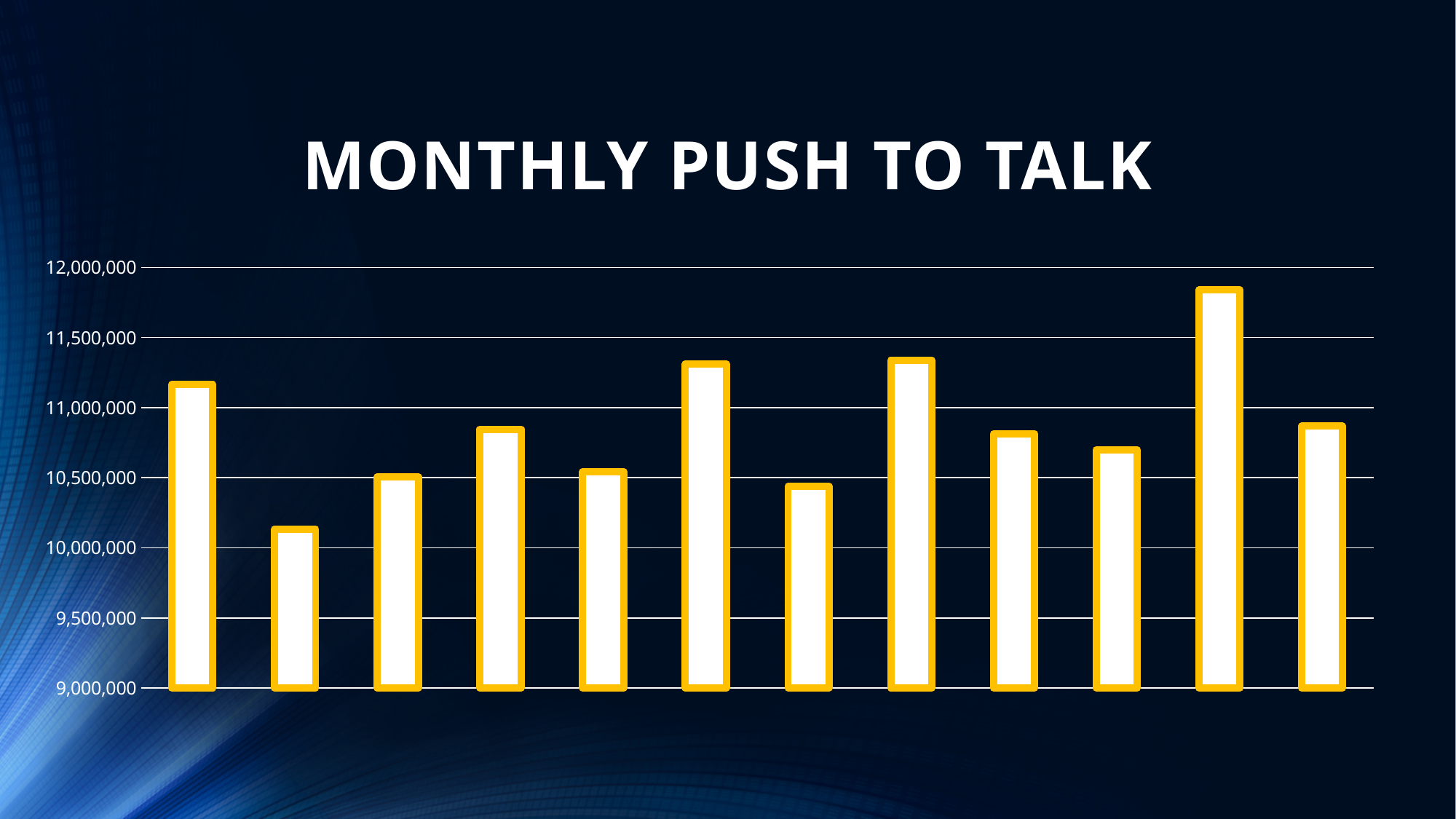
What is the title of the chart on the slide? MONTHLY PUSH TO TALK Is the value of the eleventh bar from the left greater or less than 11,500,000? greater Which bar, counting from the left, is the tallest? the eleventh bar Which is taller, the first bar from the left or the eleventh bar from the left? the eleventh bar Which is taller, the second bar from the left or the third bar from the left? the third bar Is the value of the tenth bar from the left greater or less than 10,500,000? greater Is the value of the first bar from the left greater or less than 11,000,000? greater How many bars are plotted in the chart? 12 What kind of chart is shown on the slide? bar chart Which bar, counting from the left, is the shortest? the second bar